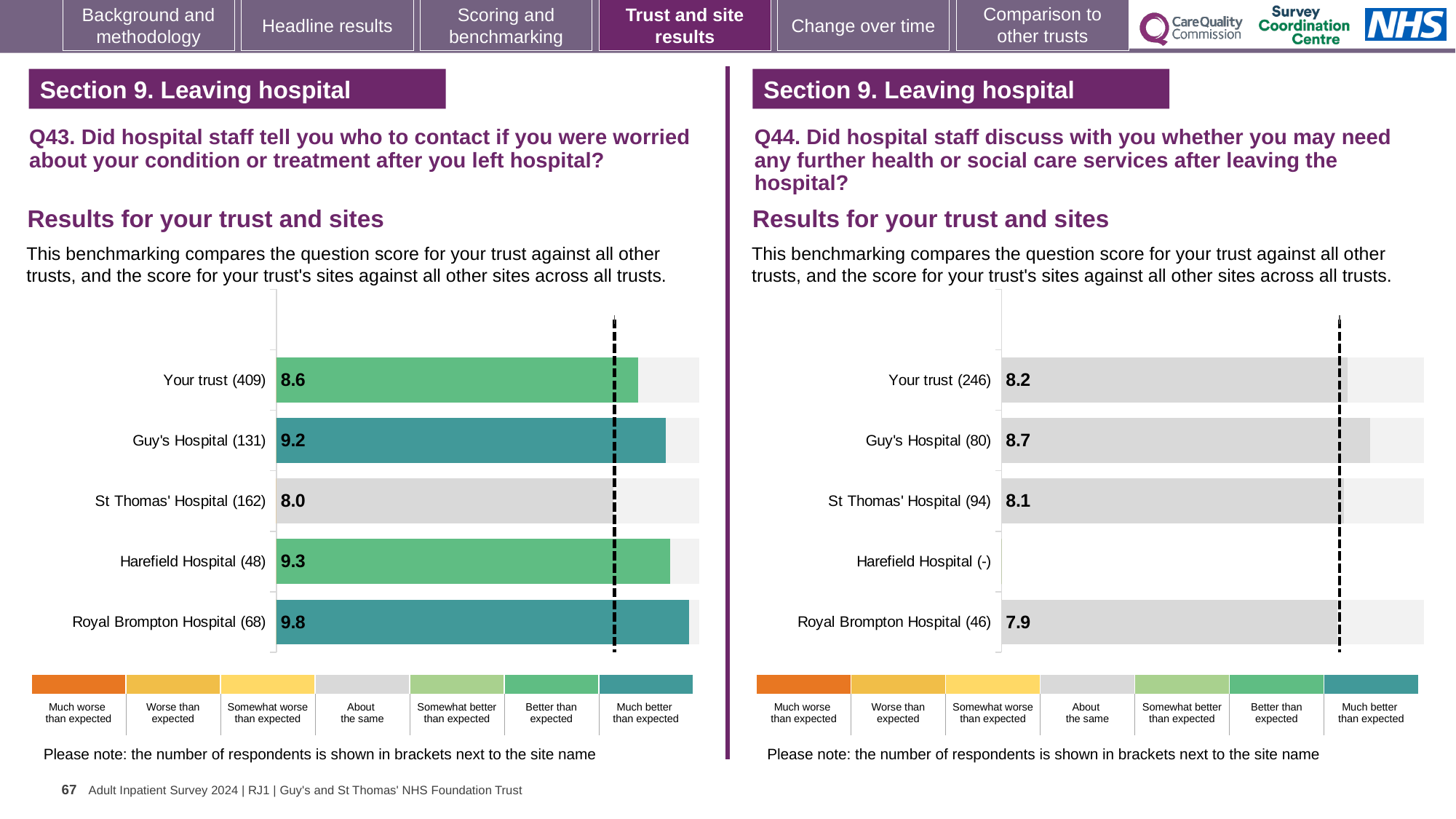
In the Q43 chart on the left, which site has the highest score? Royal Brompton Hospital (68) In the Q44 chart on the right, which is larger: the score for Your trust or the score for St Thomas' Hospital? Your trust In the Q44 chart on the right, what is the score for Royal Brompton Hospital (46)? 7.9 In the Q44 chart on the right, what is the difference between the scores for Guy's Hospital and Your trust? 0.5 In the Q44 chart on the right, what is the score for Guy's Hospital (80)? 8.7 In the Q43 chart on the left, which site has the lowest score? St Thomas' Hospital (162) In the Q43 chart on the left, what is the difference between the scores for Royal Brompton Hospital and St Thomas' Hospital? 1.8 In the Q43 chart on the left, how many sites or trust rows are plotted? 5 What type of chart is used for the Q43 results on the left? Bar chart In the Q44 chart on the right, which site with a score shown has the lowest score? Royal Brompton Hospital (46) In the Q44 chart on the right, which site has no score shown? Harefield Hospital (-) In the Q43 chart on the left, what is the score for Your trust (409)? 8.6